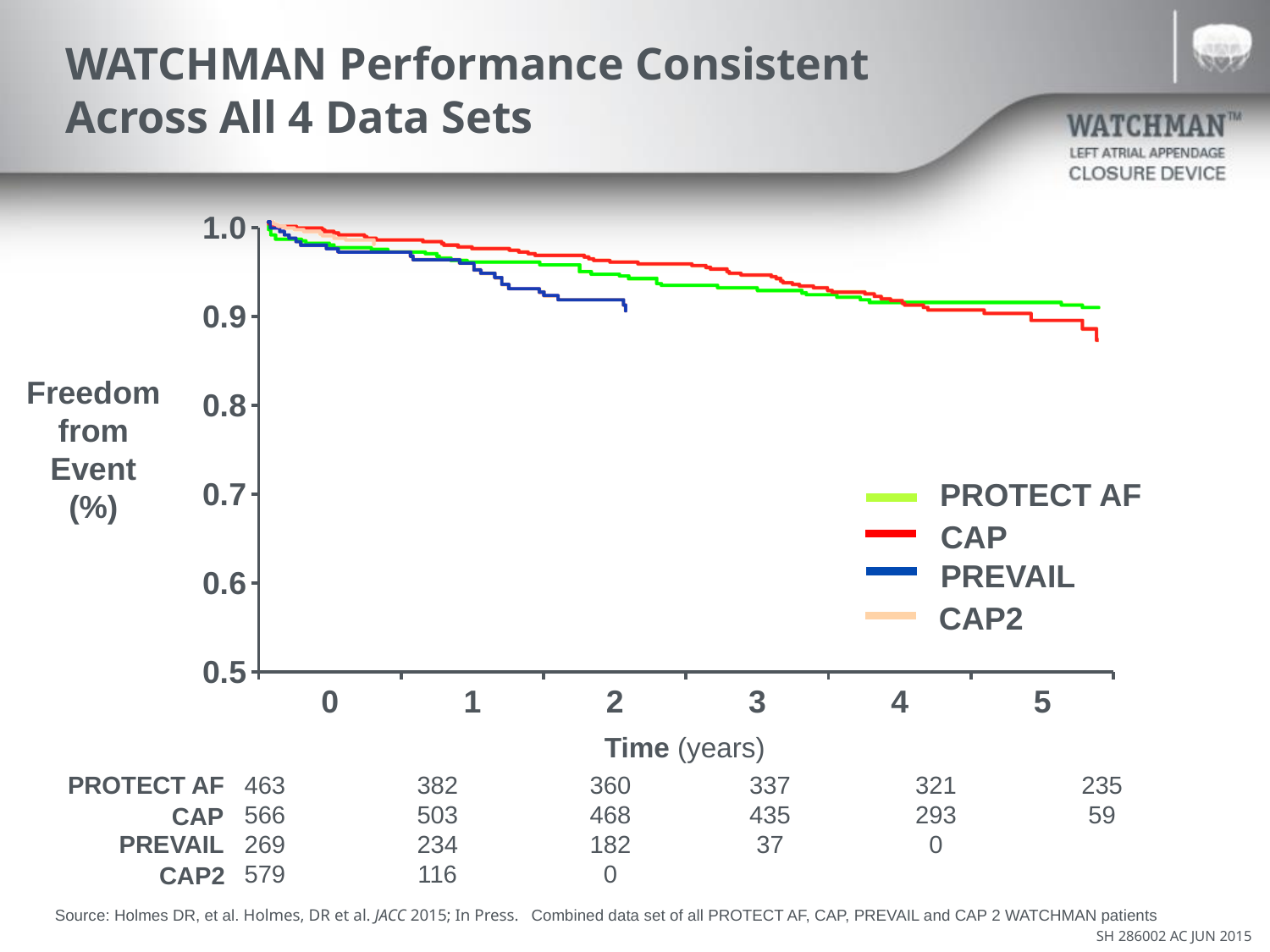
What kind of chart is shown on the slide? line chart What colour is the CAP line in the chart? red What is the difference between the CAP and PROTECT AF patient counts at 0 years? 103 At 4 years, which has more patients listed, PROTECT AF or CAP? PROTECT AF How many PROTECT AF patients are listed at 0 years? 463 Is the CAP freedom-from-event value at 3 years greater or less than 0.9? greater Which data set has the largest number of patients at 0 years in the table below the chart? CAP2 How many PREVAIL patients are listed at 3 years? 37 How many series does the legend list? 4 Do the freedom-from-event curves rise or fall as time increases? fall How many CAP patients are listed at 5 years? 59 How many CAP2 patients are listed at 1 year? 116